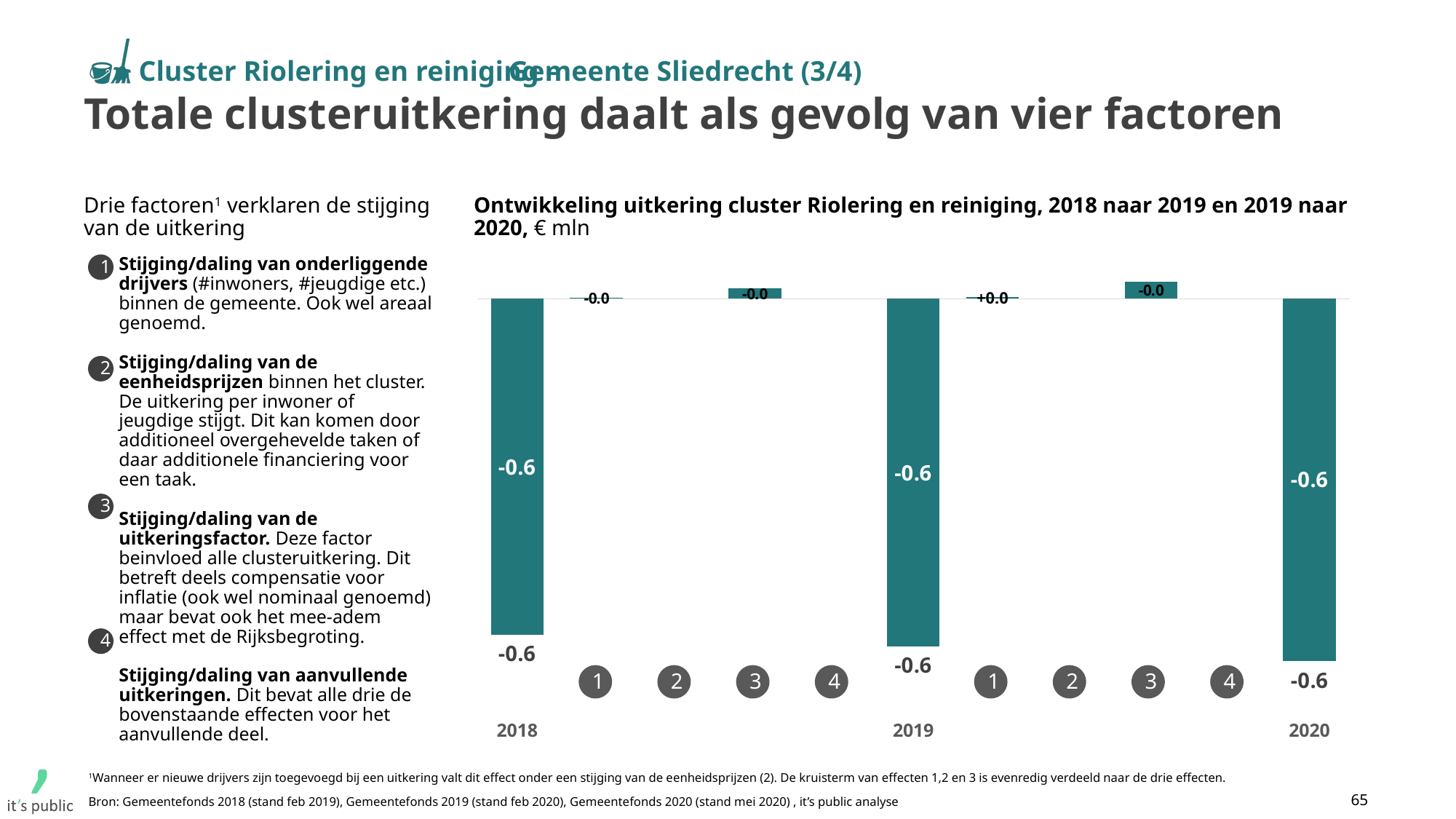
What is the value of the 2019 bar in the chart? -0.6 What is the data label on factor 3 between 2018 and 2019? -0.0 What is the data label on factor 1 between 2018 and 2019? -0.0 How many numbered factors are shown between each pair of years in the chart? 4 How many year totals (2018, 2019, 2020) are shown as large bars in the chart? 3 What kind of chart is shown on the slide? Bar chart What is the title of the chart? Ontwikkeling uitkering cluster Riolering en reiniging, 2018 naar 2019 en 2019 naar 2020, € mln What is the value of the 2018 bar in the chart? -0.6 Does the total cluster payment change between 2018 and 2020 according to the labelled values? No, it stays at -0.6 What unit is the chart expressed in? € mln What is the value of the 2020 bar in the chart? -0.6 What is the data label on factor 1 between 2019 and 2020? +0.0